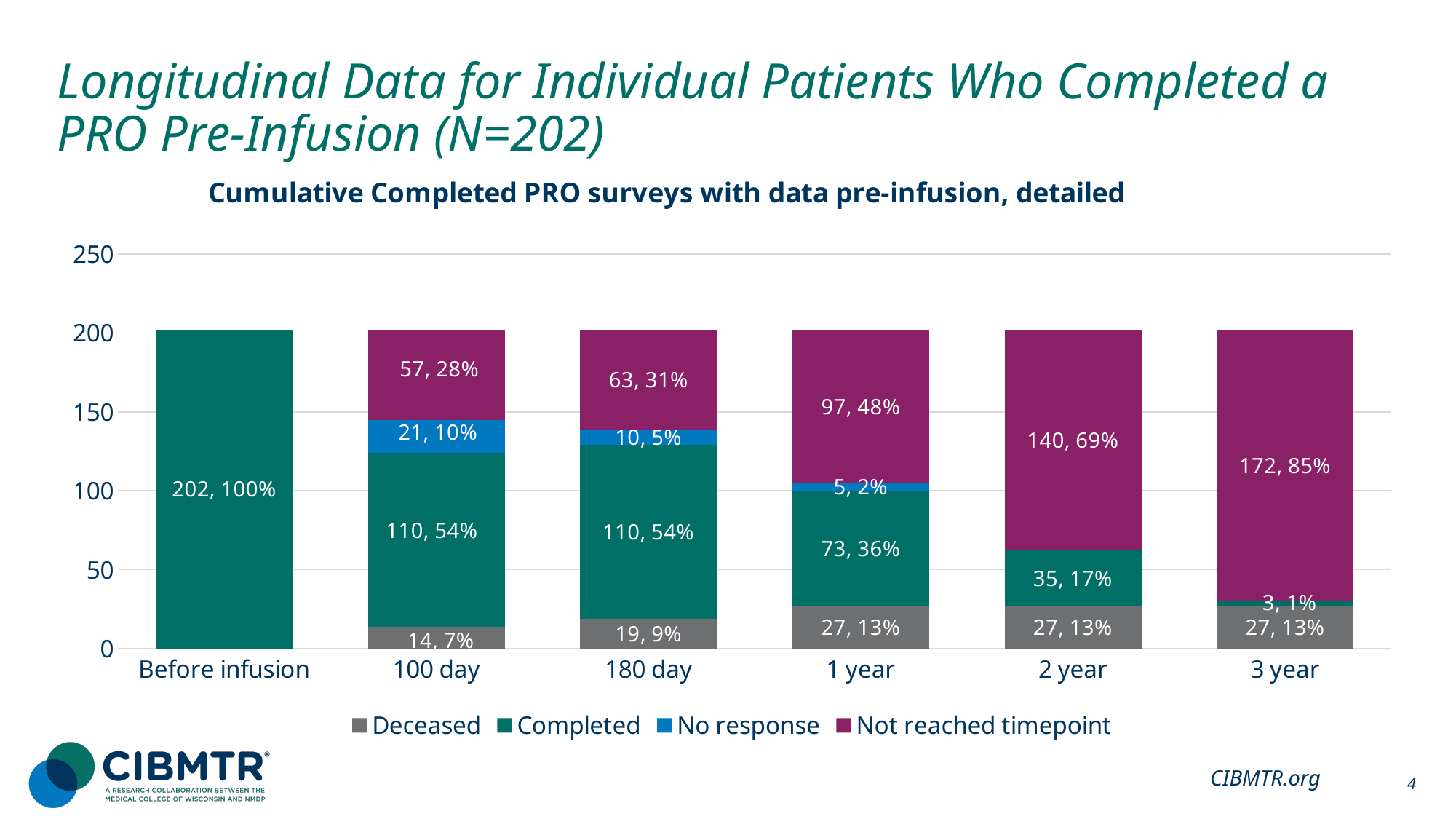
At which timepoint is the Not reached timepoint count highest? 3 year What is the difference between the Not reached timepoint counts at 2 year and 1 year? 43 What is the Completed count at 100 day? 110 What is the Deceased count at 1 year? 27 Excluding Before infusion, at which timepoint is the Completed count lowest? 3 year What is the total of the stacked bar for 100 day? 202 What is the No response count at 180 day? 10 Which is larger, the No response count at 100 day or at 180 day? 100 day What kind of chart is shown on the slide? Stacked bar chart How many series does the legend list? 4 How many timepoint categories are shown on the x axis? 6 What percentage of patients had Not reached timepoint at 3 year? 85%